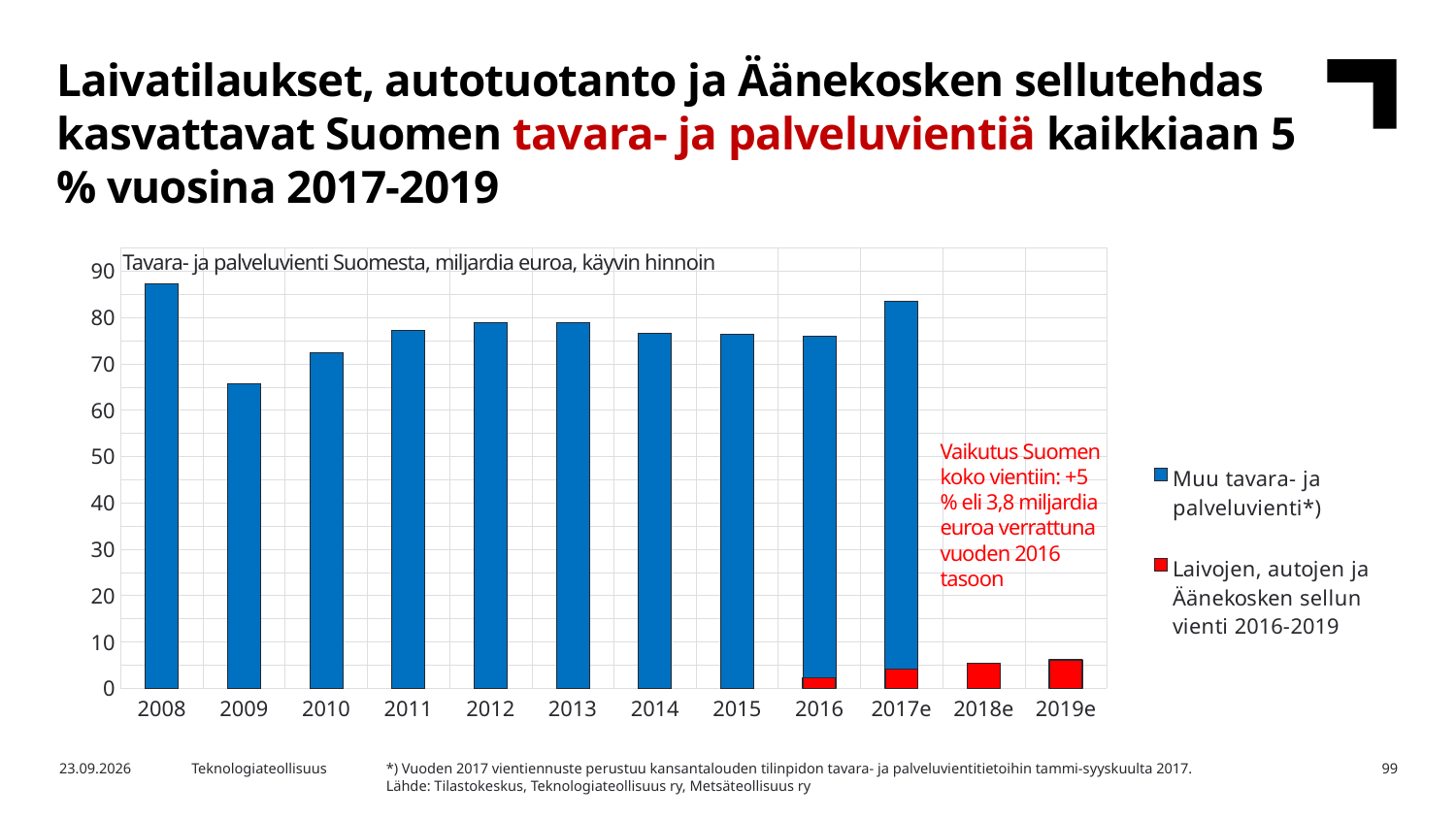
Which year has the larger bar for 'Muu tavara- ja palveluvienti*)', 2008 or 2009? 2008 Among the years 2008 to 2017e, which year has the lowest bar for 'Muu tavara- ja palveluvienti*)'? 2009 Is the value for 'Laivojen, autojen ja Äänekosken sellun vienti 2016-2019' in 2019e greater or less than 10? less What kind of chart is shown on the slide? bar chart Does the total bar height rise or fall from 2016 to 2017e? rise How many series does the chart legend list? 2 Which year has the tallest bar for 'Muu tavara- ja palveluvienti*)'? 2008 What is the title of the chart? Tavara- ja palveluvienti Suomesta, miljardia euroa, käyvin hinnoin Is the value for 'Muu tavara- ja palveluvienti*)' in 2009 greater or less than 70? less Is the value for 'Muu tavara- ja palveluvienti*)' in 2008 greater or less than 80? greater How many years are shown on the x axis of the chart? 12